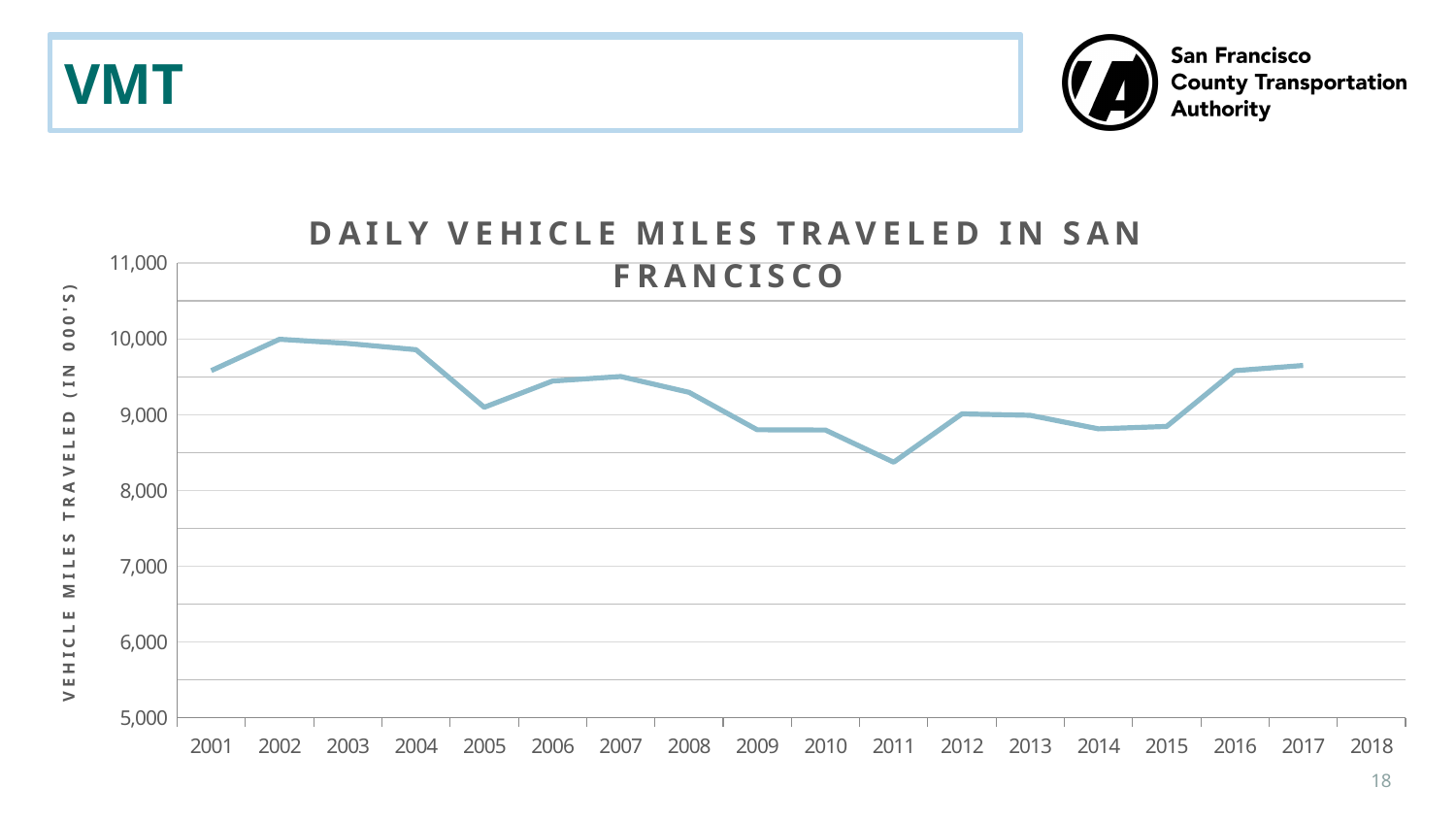
What is the title of the chart? Daily Vehicle Miles Traveled in San Francisco In which year was daily vehicle miles traveled the lowest? 2011 Is the value for 2009 greater or less than 9,000? less Is the value for 2011 greater or less than 9,000? less In which year was daily vehicle miles traveled the highest? 2002 Is the value for 2016 greater or less than 9,000? greater Which year had a higher value, 2005 or 2011? 2005 What kind of chart is shown on the slide? line chart Did daily vehicle miles traveled rise or fall between 2011 and 2017? rise Which year had a higher value, 2002 or 2017? 2002 What is the label of the vertical axis? Vehicle Miles Traveled (in 000's)